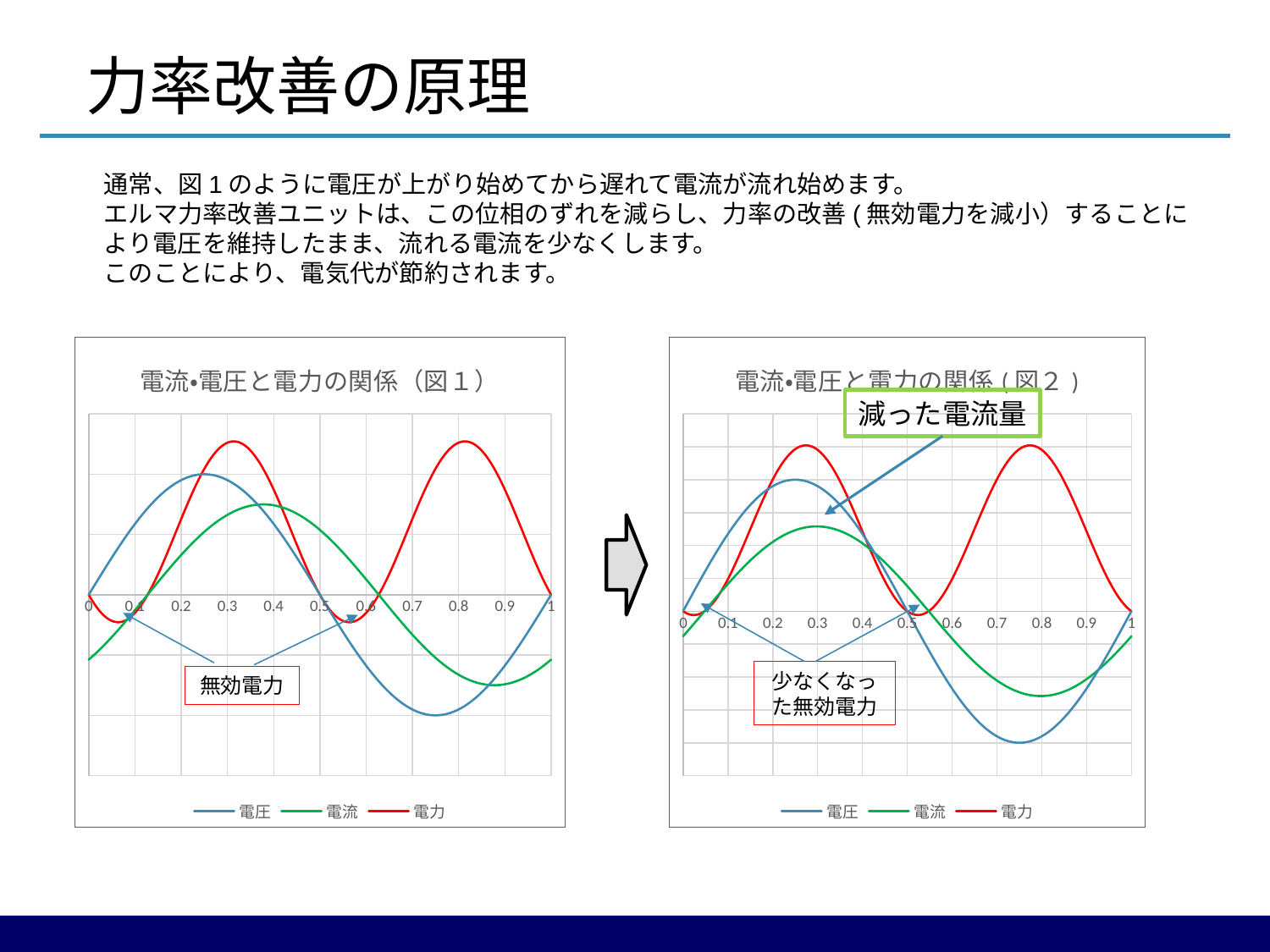
How many series does the legend of the left chart (図１) list? 3 In the left chart (図１), does the 電圧 line rise or fall between x = 0 and x = 0.2? rise In the left chart (図１), which series has the lowest peak? 電流 What is the largest x-axis tick value shown on the left chart (図１)? 1 What are the legend entries of the right chart (図２)? 電圧, 電流, 電力 What kind of chart is the left chart (図１)? line chart In the left chart (図１), which series reaches the highest peak? 電力 In the right chart (図２), does the 電流 line rise or fall between x = 0.4 and x = 0.6? fall What is the title of the left chart? 電流•電圧と電力の関係（図１） How many series does the legend of the right chart (図２) list? 3 In the right chart (図２), which series reaches the highest peak? 電力 In the right chart (図２), which peaks higher, 電圧 or 電流? 電圧